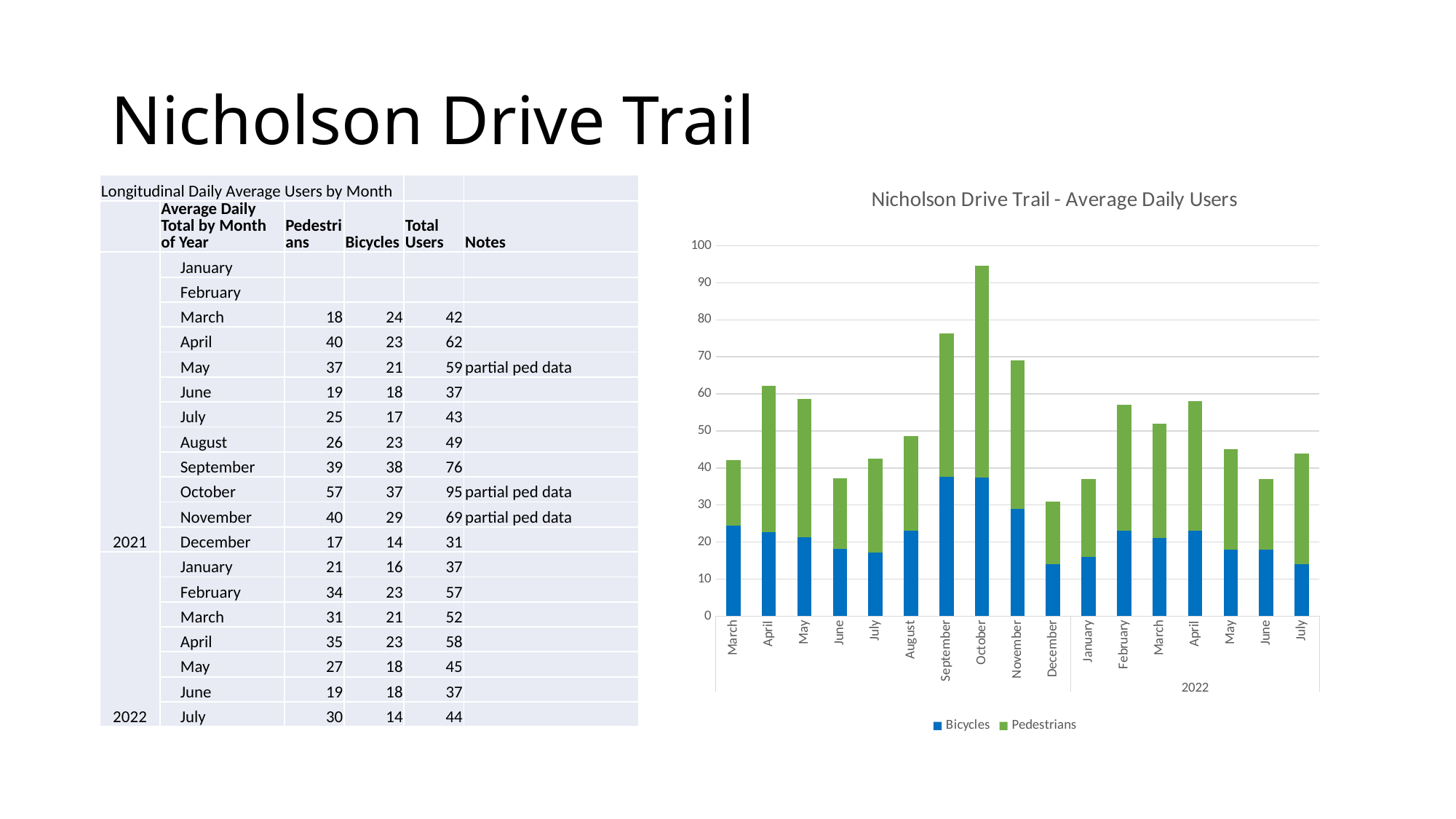
According to the table on the slide, what is the Total Users value for October 2021? 95 What is the title of the chart on the slide? Nicholson Drive Trail - Average Daily Users What kind of chart is shown on the slide? bar chart Is the total stacked bar for October greater or less than 90 in the Nicholson Drive Trail - Average Daily Users chart? greater Is the total stacked bar for December greater or less than 40 in the Nicholson Drive Trail - Average Daily Users chart? less In the Nicholson Drive Trail - Average Daily Users chart, do the stacked bar totals rise or fall from October to December? fall How many series does the legend of the Nicholson Drive Trail - Average Daily Users chart list? 2 How many monthly bars are plotted in the Nicholson Drive Trail - Average Daily Users chart? 17 What colour represents Bicycles in the Nicholson Drive Trail - Average Daily Users chart? blue In the Nicholson Drive Trail - Average Daily Users chart, which stacked bar is taller, September or November? September Which month has the shortest stacked bar in the Nicholson Drive Trail - Average Daily Users chart? December Which month has the tallest stacked bar in the Nicholson Drive Trail - Average Daily Users chart? October